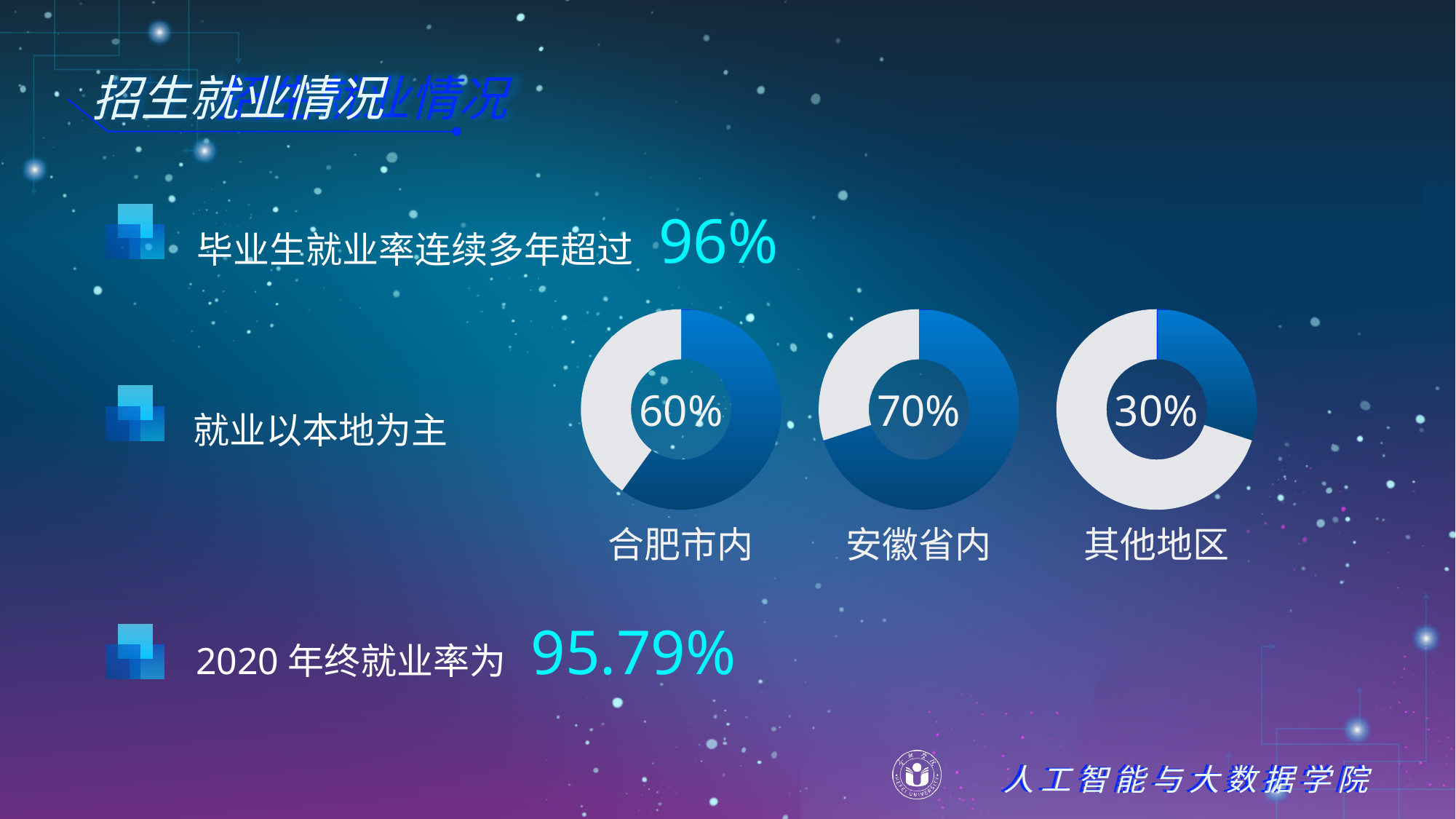
What percentage is shown in the 合肥市内 donut chart? 60% What percentage is shown in the 安徽省内 donut chart? 70% Which of the three donut charts shows the highest percentage? 安徽省内 What is the difference between the percentages shown in the 安徽省内 and 合肥市内 donut charts? 10% What kind of chart is used to show the 合肥市内, 安徽省内 and 其他地区 percentages? Donut (pie) chart How many donut charts are on the slide? 3 What percentage is shown in the 其他地区 donut chart? 30% Which of the three donut charts shows the lowest percentage? 其他地区 What is the label under the middle donut chart? 安徽省内 In the 其他地区 donut chart, what colour is the 30% portion? Blue What is the difference between the percentages shown in the 合肥市内 and 其他地区 donut charts? 30% Which shows a larger percentage, the 合肥市内 donut chart or the 其他地区 donut chart? 合肥市内